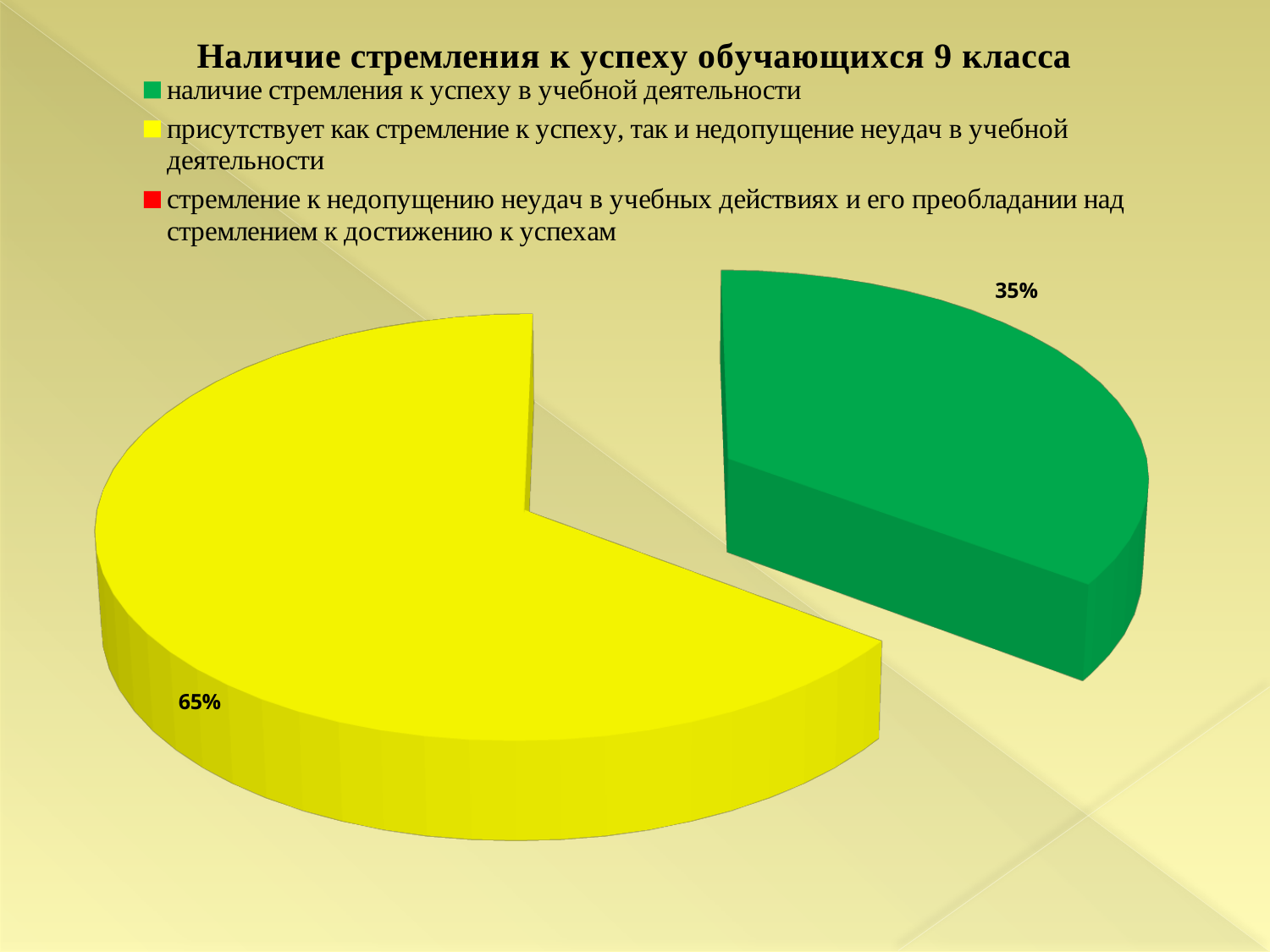
What is the difference in percentage points between the yellow slice and the green slice? 30 What is the title of the chart? Наличие стремления к успеху обучающихся 9 класса What percentage is shown for the yellow slice (присутствует как стремление к успеху, так и недопущение неудач в учебной деятельности)? 65% What kind of chart is shown on the slide? pie chart What percentage is shown for the green slice (наличие стремления к успеху в учебной деятельности)? 35% What colour is the legend marker for 'стремление к недопущению неудач в учебных действиях и его преобладании над стремлением к достижению к успехам'? red How many entries does the legend list? 3 How many slices with data labels are visible in the pie? 2 Which category has the largest share of the pie? присутствует как стремление к успеху, так и недопущение неудач в учебной деятельности Which slice is larger, the green one or the yellow one? the yellow one Which of the two labelled slices has the smaller share? наличие стремления к успеху в учебной деятельности Is the share of the green slice greater or less than 50%? less